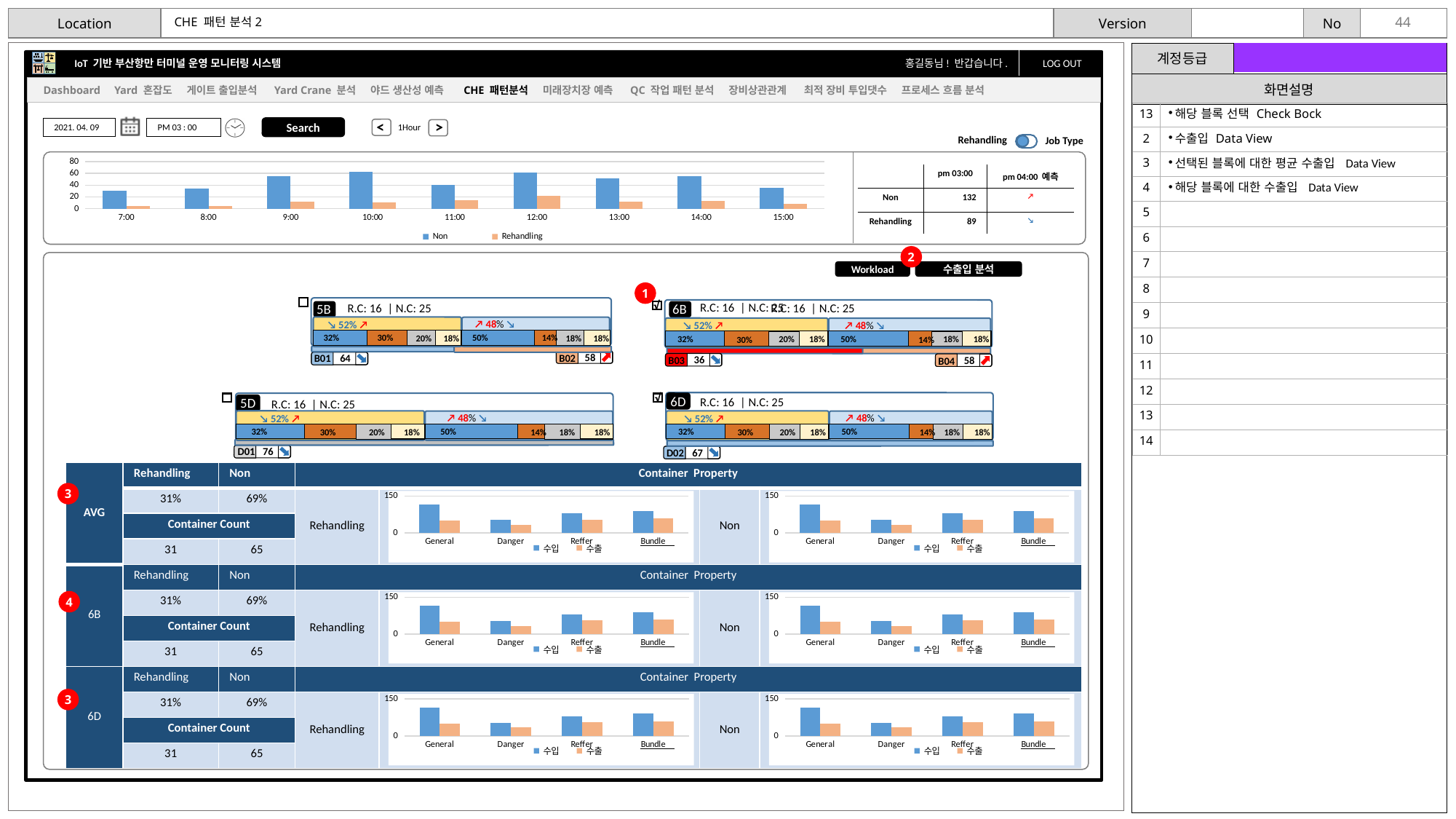
In the AVG row's Rehandling Container Property chart, which category has the highest 수입 value? General In the hourly bar chart at the top of the slide, which is larger for the Non series, 9:00 or 11:00? 9:00 In the hourly bar chart at the top of the slide, which is larger at 12:00, Non or Rehandling? Non What kind of chart is the hourly chart at the top of the slide? bar chart How many series does the legend of the hourly bar chart at the top of the slide list? 2 In the hourly bar chart at the top of the slide, at which hour is the Rehandling value highest? 12:00 How many time categories does the hourly bar chart at the top of the slide show on its x axis? 9 In the AVG row's Rehandling Container Property chart, how many categories are shown on the x axis? 4 In the hourly bar chart at the top of the slide, is the Non value at 10:00 greater or less than 40? greater In the hourly bar chart at the top of the slide, is the Non value at 7:00 greater or less than 40? less In the hourly bar chart at the top of the slide, which series is shown in orange? Rehandling In the hourly bar chart at the top of the slide, is the Rehandling value at 12:00 greater or less than 40? less